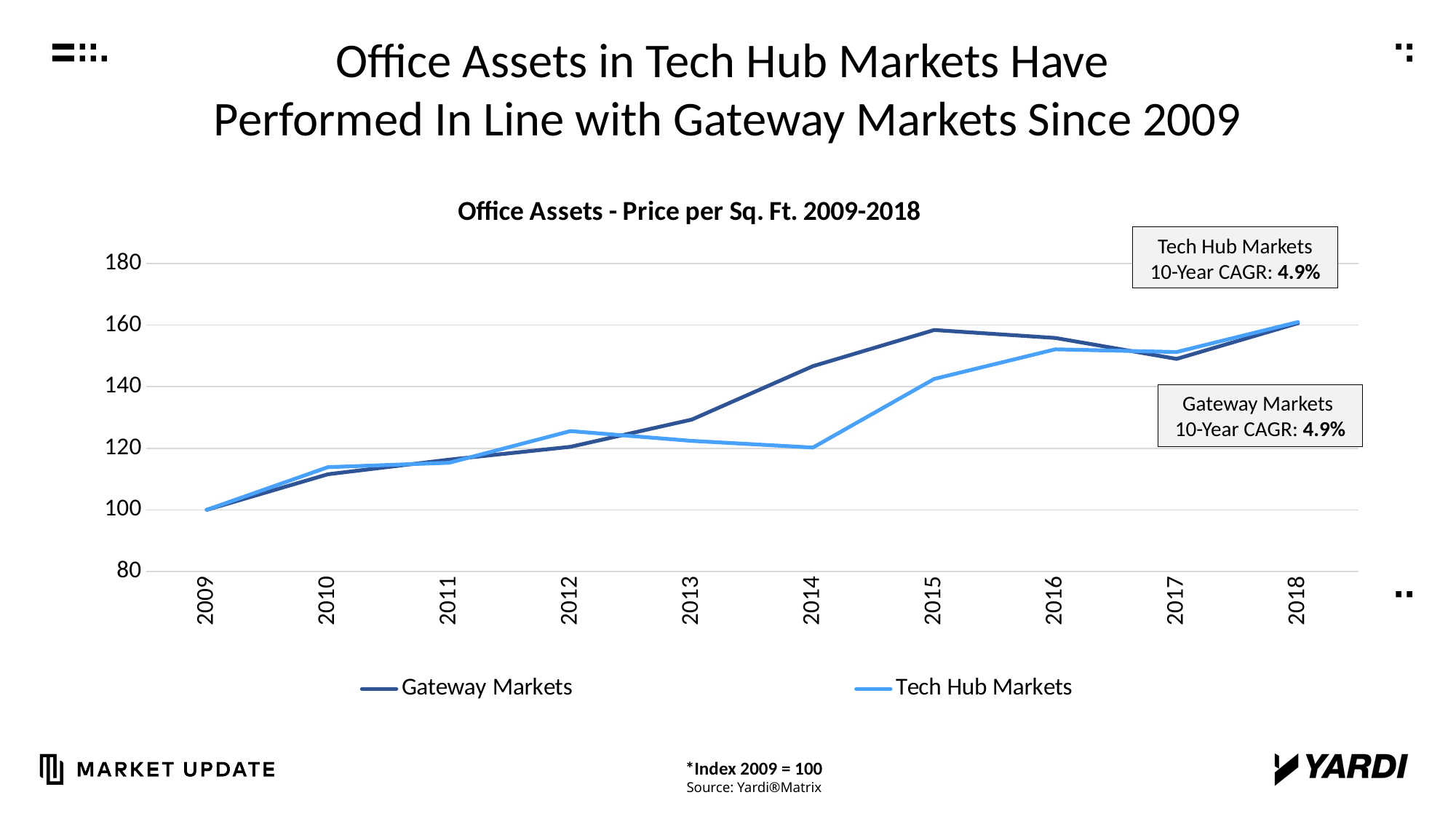
In 2012, which series has the higher value, Gateway Markets or Tech Hub Markets? Tech Hub Markets Does the Tech Hub Markets line rise or fall between 2012 and 2014? fall How many years are plotted along the x axis? 10 What kind of chart is shown on the slide? Line chart In which year does the Tech Hub Markets line reach its highest value? 2018 In which year is the Tech Hub Markets line at its lowest value? 2009 Is the value for Gateway Markets in 2015 greater or less than 140? greater What 10-year CAGR is shown for Tech Hub Markets? 4.9% Is the value for Tech Hub Markets in 2014 greater or less than 140? less How many series does the legend list? 2 In 2014, which series has the higher value, Gateway Markets or Tech Hub Markets? Gateway Markets What is the index value for Gateway Markets in 2009? 100